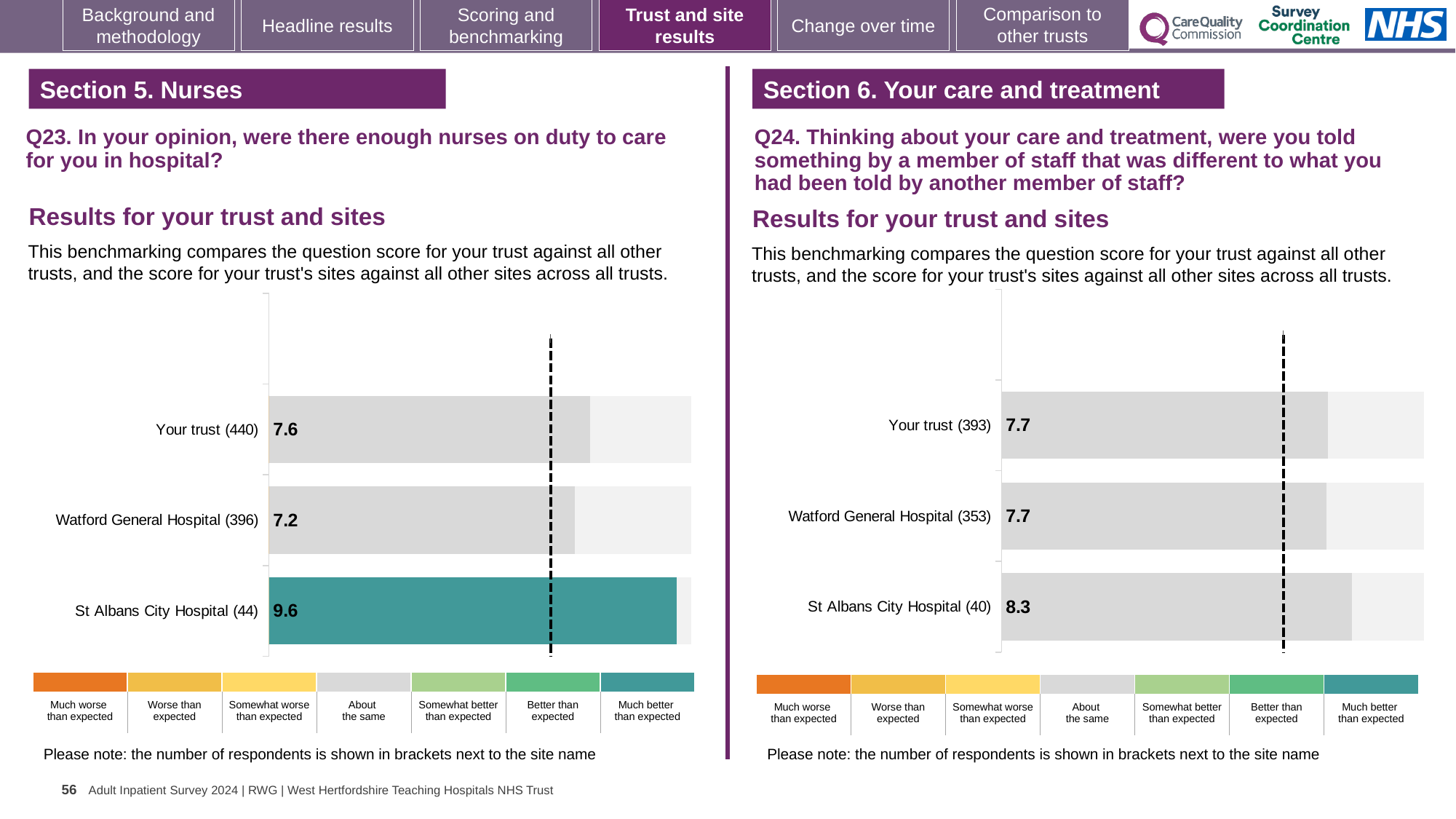
On the Q24 chart (right), what is the difference between the scores for St Albans City Hospital and Your trust? 0.6 On the Q23 chart (left), what is the score for Your trust? 7.6 On the Q23 chart (left), which site or trust has the highest score? St Albans City Hospital What kind of chart is used on the Q23 chart (left)? Bar chart On the Q24 chart (right), what is the score for St Albans City Hospital? 8.3 On the Q23 chart (left), how many respondents are shown in brackets for St Albans City Hospital? 44 On the Q24 chart (right), which site or trust has the highest score? St Albans City Hospital On the Q23 chart (left), how many bars are plotted? 3 On the Q23 chart (left), what is the score for St Albans City Hospital? 9.6 On the Q24 chart (right), what is the score for Watford General Hospital? 7.7 On the Q23 chart (left), what is the difference between the scores for St Albans City Hospital and Watford General Hospital? 2.4 On the Q23 chart (left), which site or trust has the lowest score? Watford General Hospital